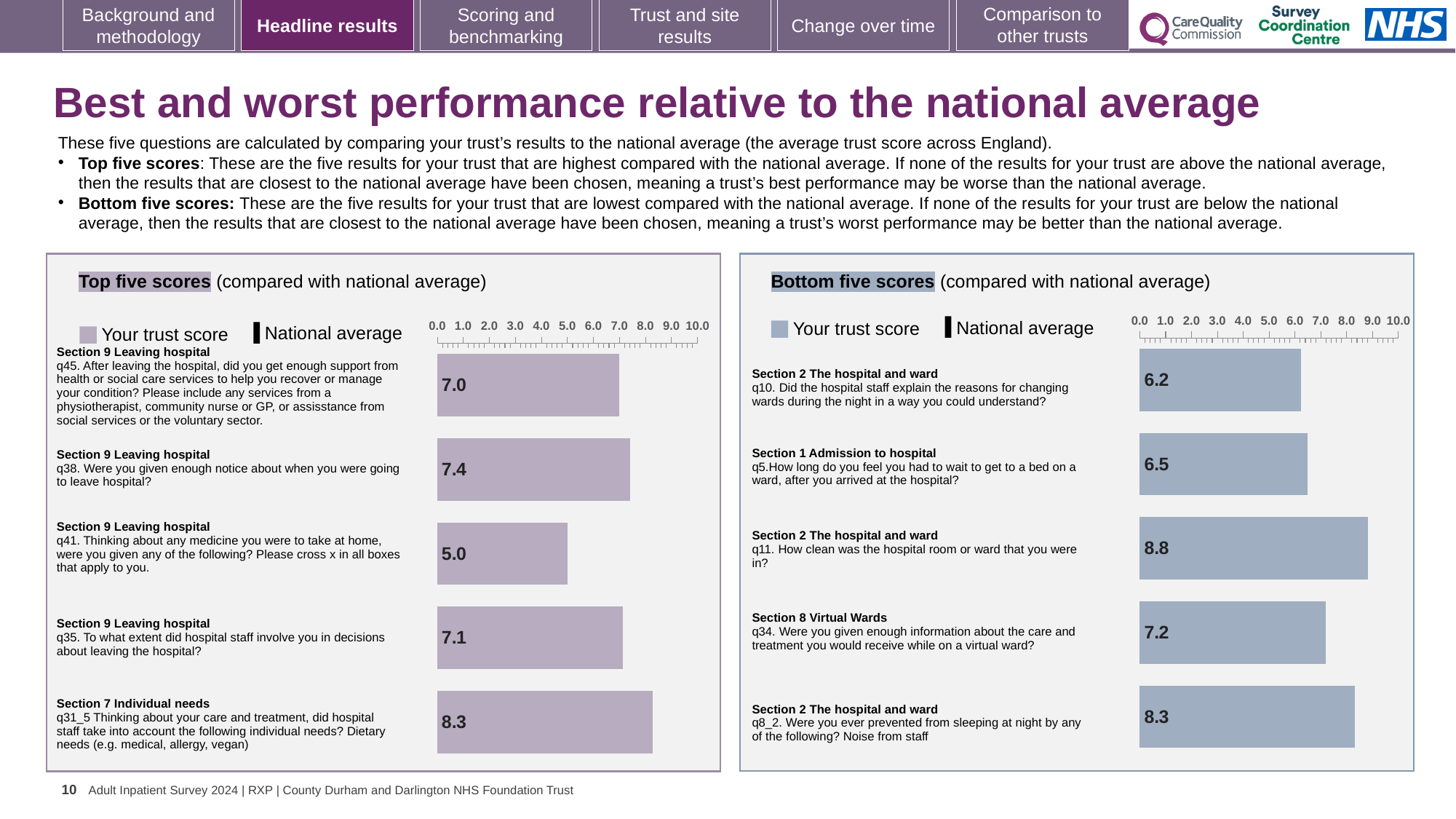
In the Bottom five scores chart, what is the trust score for q5 (wait to get to a bed on a ward)? 6.5 In the Top five scores chart, what is the difference between the trust scores for q31_5 and q41? 3.3 How many questions are plotted in the Bottom five scores chart? 5 In the Bottom five scores chart, which question has the highest trust score? q11 In the Top five scores chart, which has the larger trust score, q45 or q35? q35 In the Top five scores chart, which question has the lowest trust score? q41 In the Bottom five scores chart, which question has the lowest trust score? q10 What type of chart is the Top five scores chart? Bar chart In the Bottom five scores chart, what is the trust score for q11 (how clean was the hospital room or ward)? 8.8 In the Bottom five scores chart, what is the difference between the trust scores for q11 and q10? 2.6 In the Top five scores chart, what is the trust score for q38 (notice about when you were going to leave hospital)? 7.4 In the Top five scores chart, what is the trust score for q31_5 (dietary needs)? 8.3